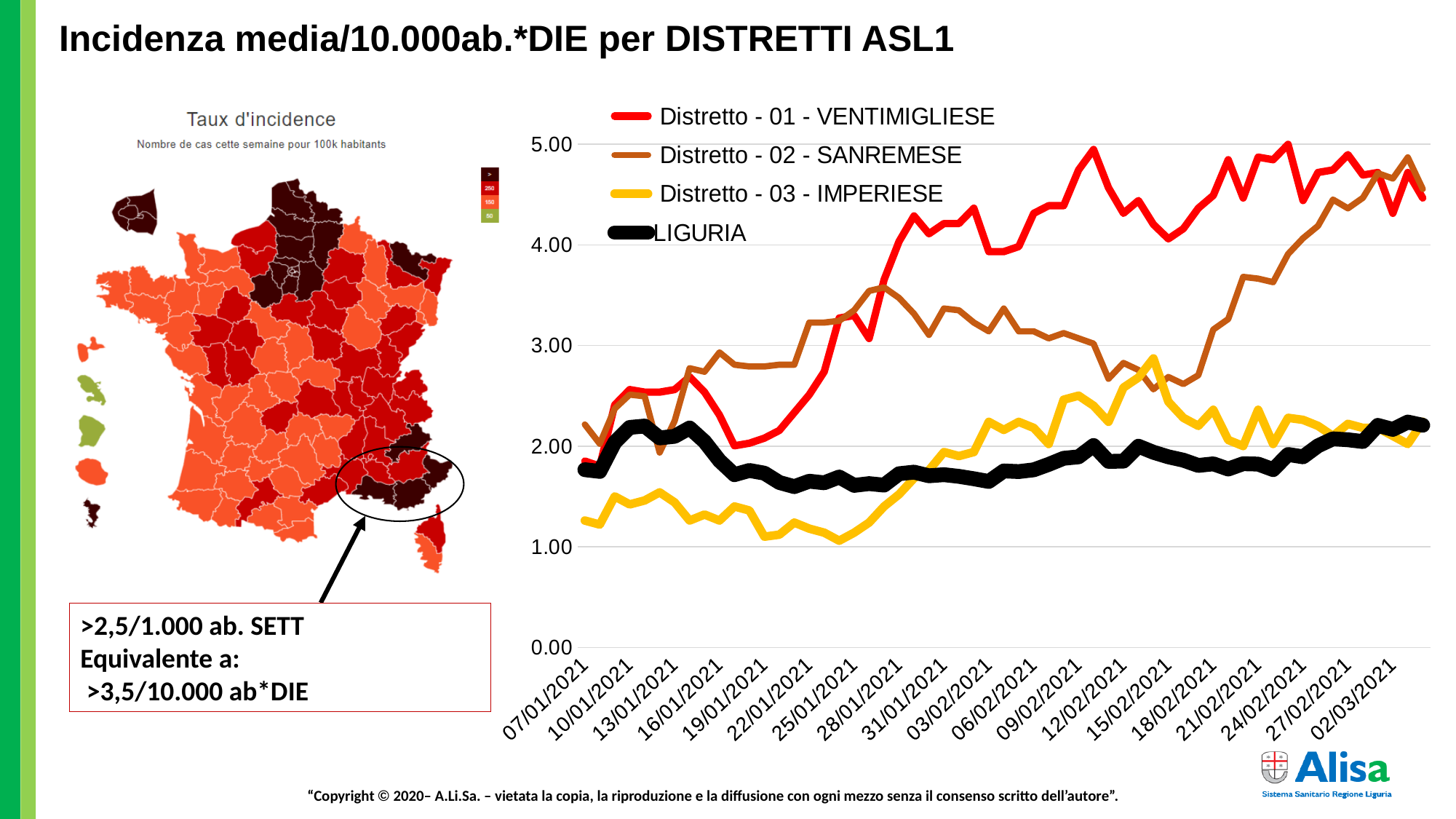
What kind of chart is shown on the right of the slide? line chart How many date labels are shown on the x axis of the line chart? 19 Is the value for Distretto - 01 - VENTIMIGLIESE at 02/03/2021 greater or less than 4.00? greater How many series does the legend of the line chart list? 4 Does the value for Distretto - 01 - VENTIMIGLIESE generally rise or fall from 07/01/2021 to 02/03/2021? rise Is the value for Distretto - 03 - IMPERIESE at 07/01/2021 greater or less than 2.00? less Which series has the highest value at 12/02/2021 in the line chart? Distretto - 01 - VENTIMIGLIESE At 07/01/2021, which is larger: the value for LIGURIA or the value for Distretto - 03 - IMPERIESE? LIGURIA Which series in the line chart is drawn in black? LIGURIA Which series in the line chart is drawn in red? Distretto - 01 - VENTIMIGLIESE Is the value for LIGURIA at 02/03/2021 greater or less than 3.00? less Which series has the lowest value at 07/01/2021 in the line chart? Distretto - 03 - IMPERIESE